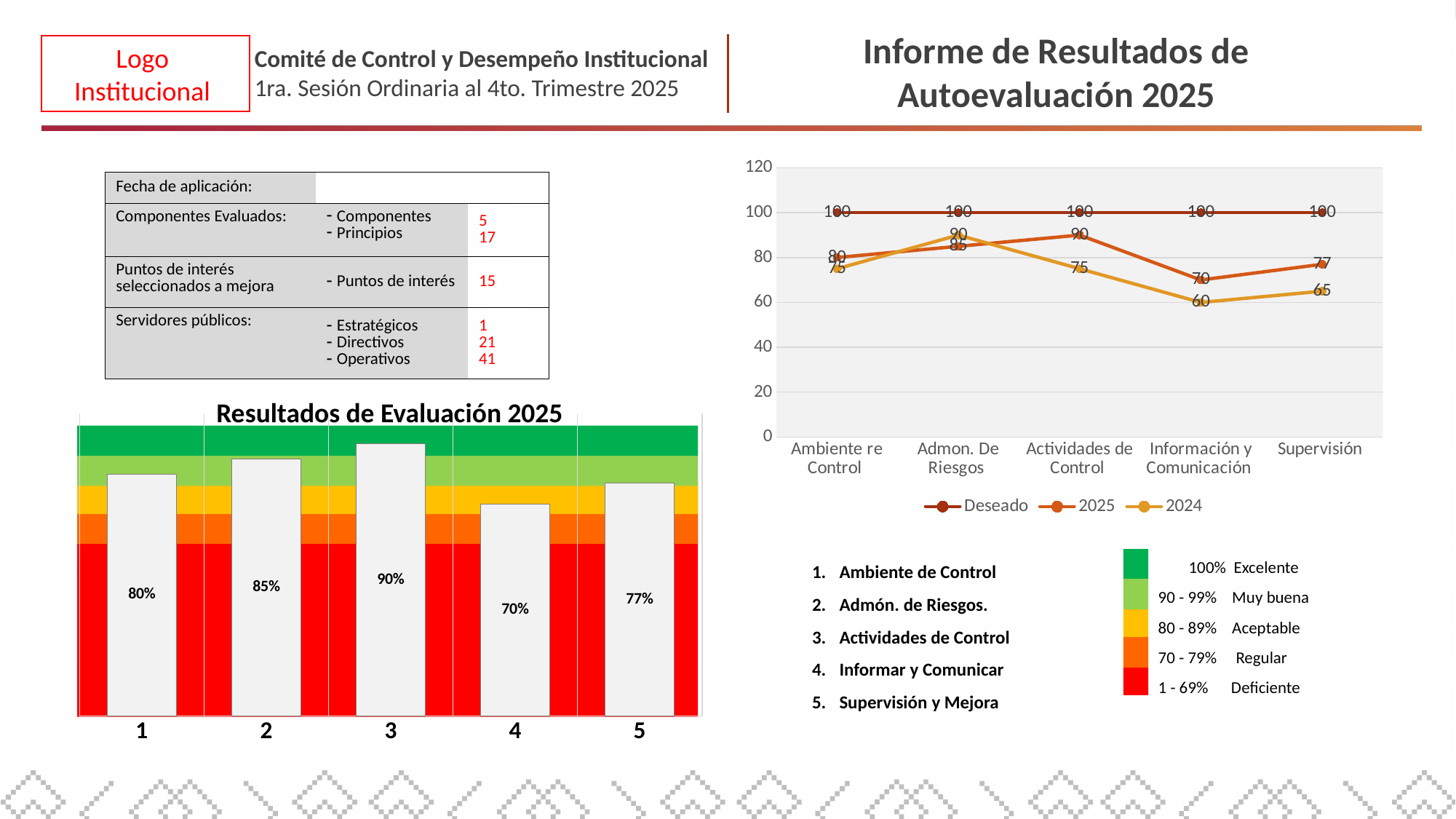
What kind of chart is the one titled 'Resultados de Evaluación 2025'? Bar chart In the line chart on the right of the slide, what are the three legend entries? Deseado, 2025, 2024 In the line chart on the right of the slide, what is the 2025 value for 'Supervisión'? 77 In the bar chart titled 'Resultados de Evaluación 2025', which category has the highest value? 3 In the line chart on the right of the slide, what is the difference between the Deseado value and the 2025 value for 'Información y Comunicación'? 30 In the bar chart titled 'Resultados de Evaluación 2025', what is the value for category 3? 90% In the line chart on the right of the slide, how many series does the legend list? 3 In the line chart on the right of the slide, which is larger for 'Actividades de Control': the 2025 value or the 2024 value? 2025 In the bar chart titled 'Resultados de Evaluación 2025', how many bars are plotted? 5 In the bar chart titled 'Resultados de Evaluación 2025', what is the difference between the values for category 2 and category 4? 15% In the bar chart titled 'Resultados de Evaluación 2025', which category has the lowest value? 4 In the line chart on the right of the slide, what is the 2024 value for 'Información y Comunicación'? 60